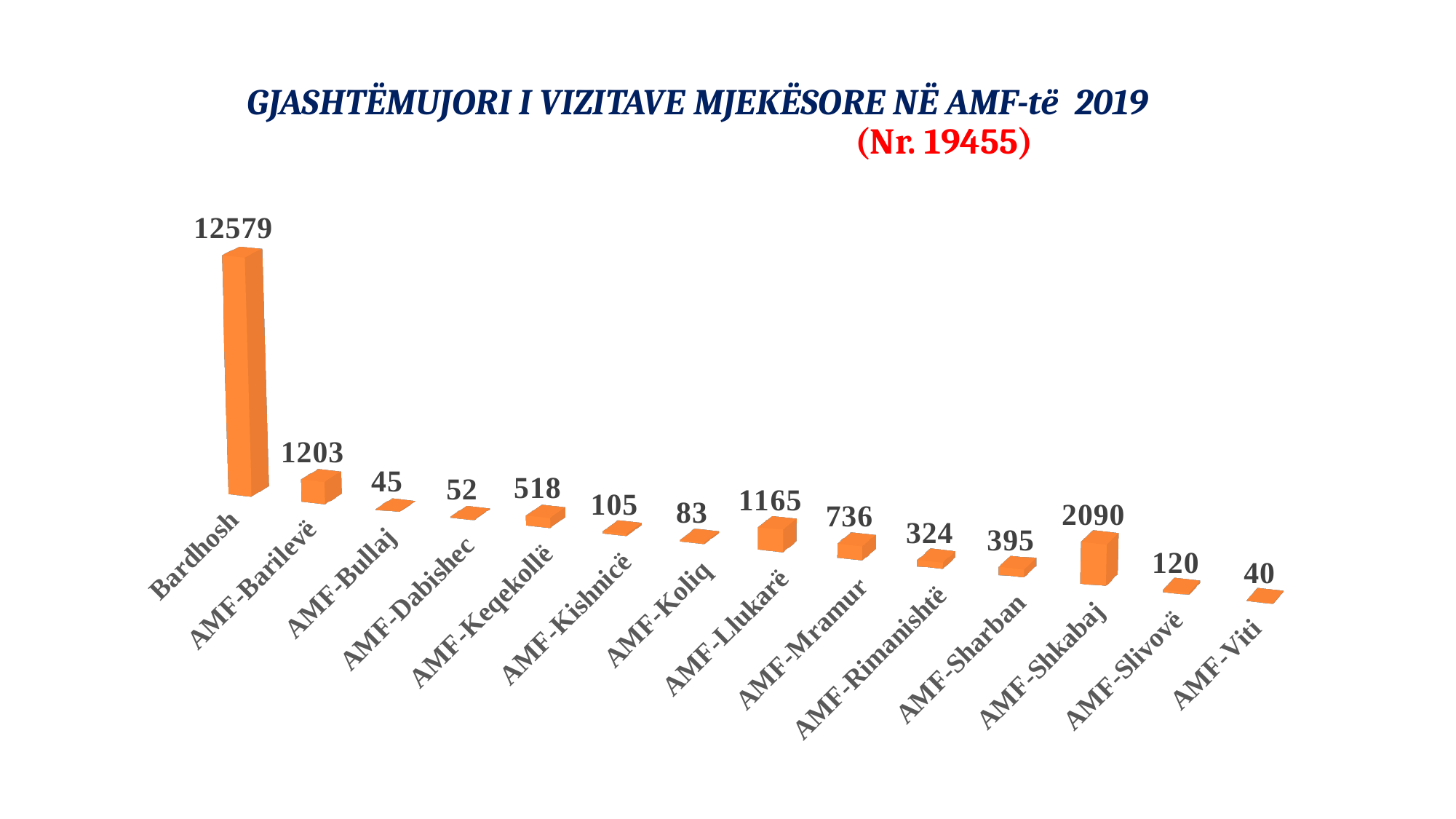
Which has a larger value, AMF-Barilevë or AMF-Llukarë? AMF-Barilevë What is the value shown for AMF-Mramur? 736 Which category has the highest value? Bardhosh What is the value shown for AMF-Keqekollë? 518 What is the difference between the values for AMF-Shkabaj and AMF-Barilevë? 887 What is the difference between the values for AMF-Mramur and AMF-Rimanishtë? 412 How many categories are shown in the chart? 14 What is the value shown for Bardhosh? 12579 What is the value shown for AMF-Shkabaj? 2090 What kind of chart is shown on the slide? Bar chart What total number is given in red in the chart title? Nr. 19455 Which category has the lowest value? AMF-Viti